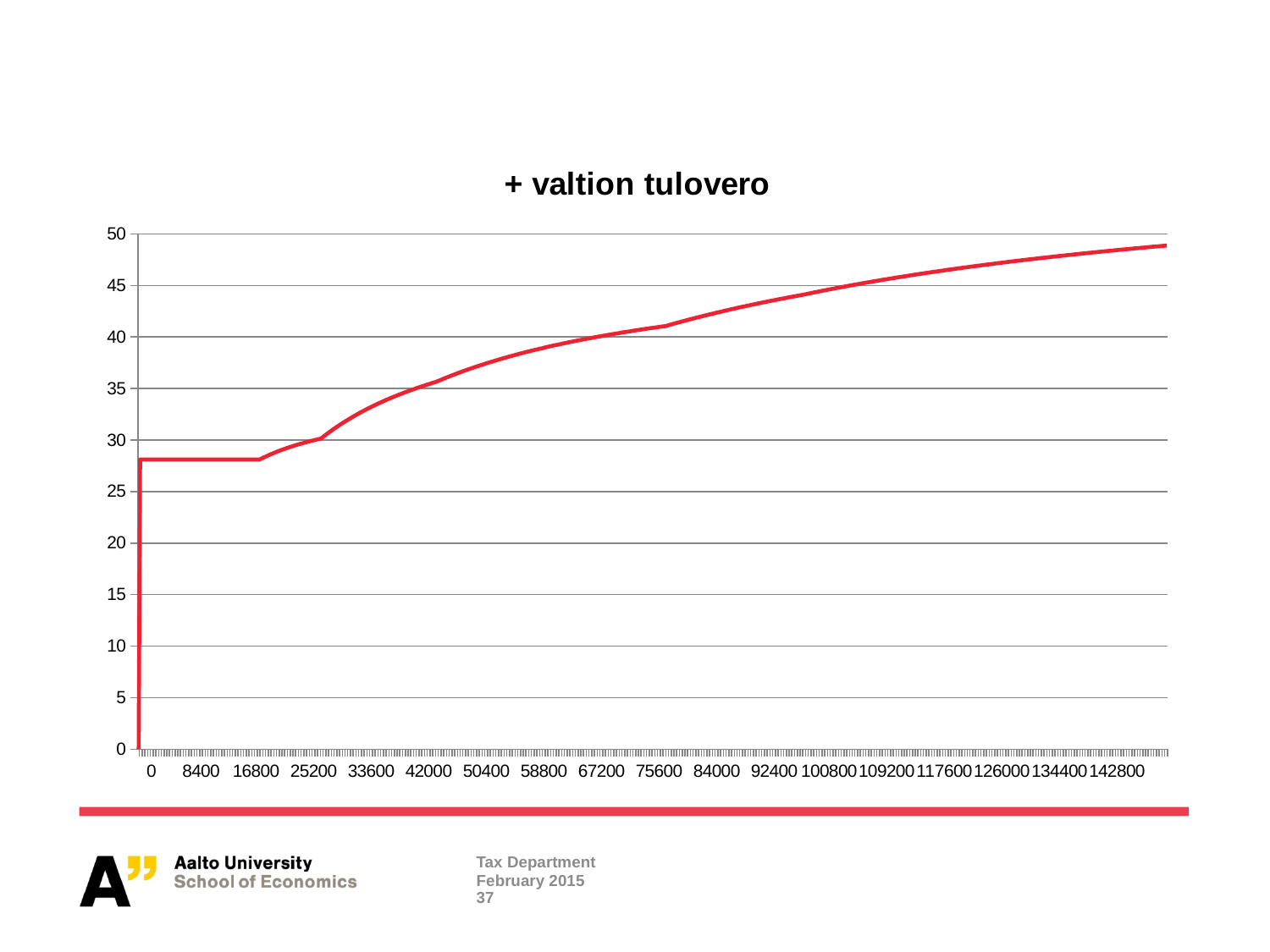
Is the value at 142800 greater or less than 50? less What is the title of the chart? + valtion tulovero Is the value at 84000 greater or less than 40? greater Which is larger, the value at 8400 or the value at 142800? 142800 What kind of chart is shown on the slide? line chart Is the value at 142800 greater or less than 45? greater What colour is the plotted line? red Does the plotted line rise or fall as the x-axis values increase from 16800 to 142800? rise